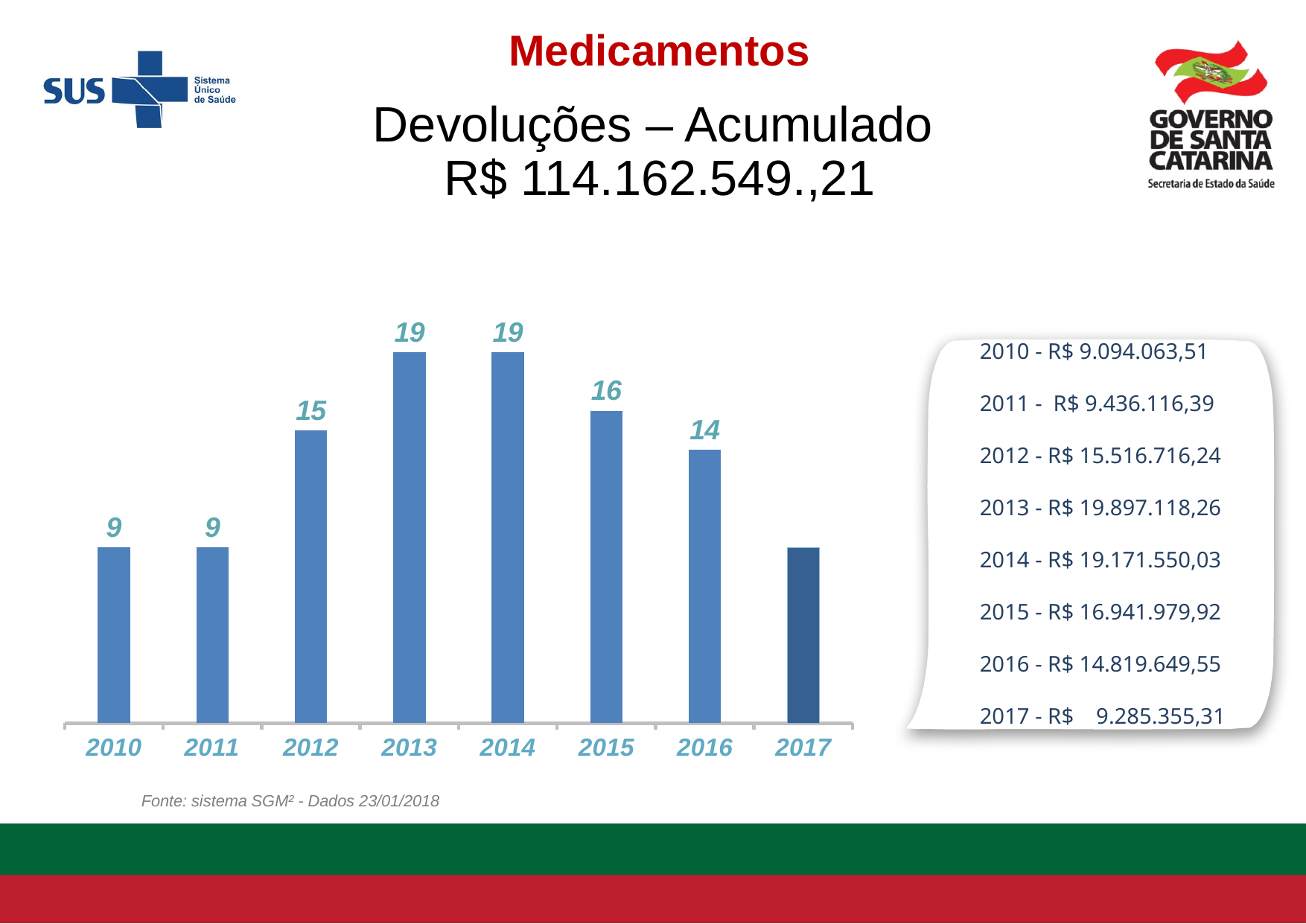
Do the values rise or fall from 2014 to 2016? Fall What kind of chart is shown on the slide? Bar chart How many years are shown on the x axis of the chart? 8 What is the value shown for 2012? 15 What is the difference between the values for 2013 and 2012? 4 What is the value shown for 2016? 14 What is the value shown for 2010? 9 Which year's bar is drawn in a darker blue than the others? 2017 What is the highest data label value shown on the chart? 19 What is the value shown for 2013? 19 Which year has the larger value, 2012 or 2016? 2012 What is the difference between the values for 2015 and 2016? 2